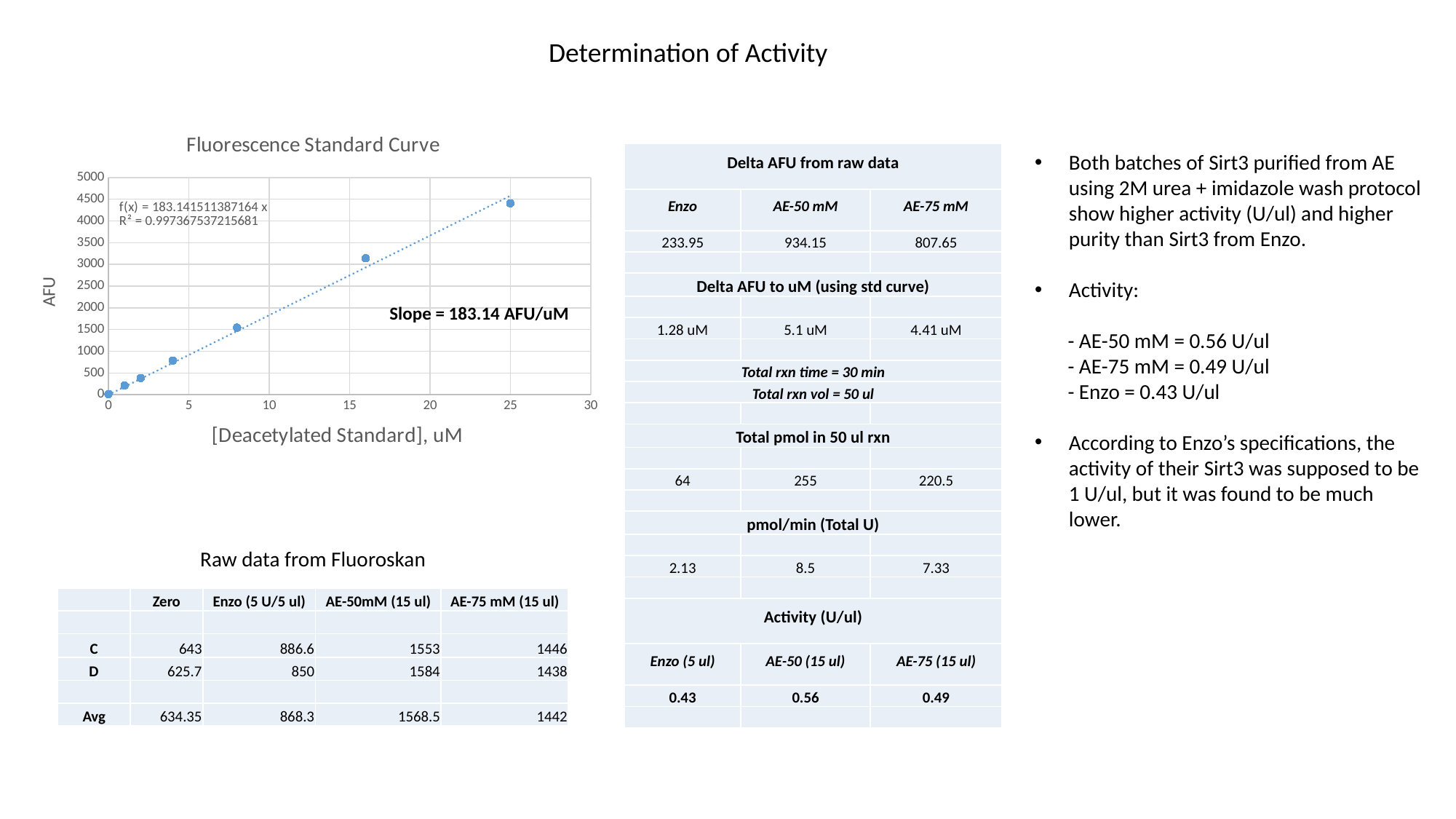
What kind of chart is the Fluorescence Standard Curve? scatter plot In the Fluorescence Standard Curve chart, is the AFU value for the point at 25 uM greater or less than 4000? greater What is the maximum value shown on the y axis of the Fluorescence Standard Curve chart? 5000 What is the title of the chart on the slide? Fluorescence Standard Curve In the Fluorescence Standard Curve chart, which point has the highest AFU value: the one at 16 uM or the one at 25 uM? 25 uM What R² value is shown for the trendline in the Fluorescence Standard Curve chart? 0.997367537215681 Do the AFU values rise or fall as the deacetylated standard concentration increases in the Fluorescence Standard Curve chart? rise How many data points are plotted in the Fluorescence Standard Curve chart? 7 What is the label of the x axis of the Fluorescence Standard Curve chart? [Deacetylated Standard], uM In the Fluorescence Standard Curve chart, is the AFU value for the point at 8 uM greater or less than 2000? less In the Fluorescence Standard Curve chart, is the AFU value for the point at 16 uM greater or less than 3500? less What slope is annotated on the Fluorescence Standard Curve chart? 183.14 AFU/uM